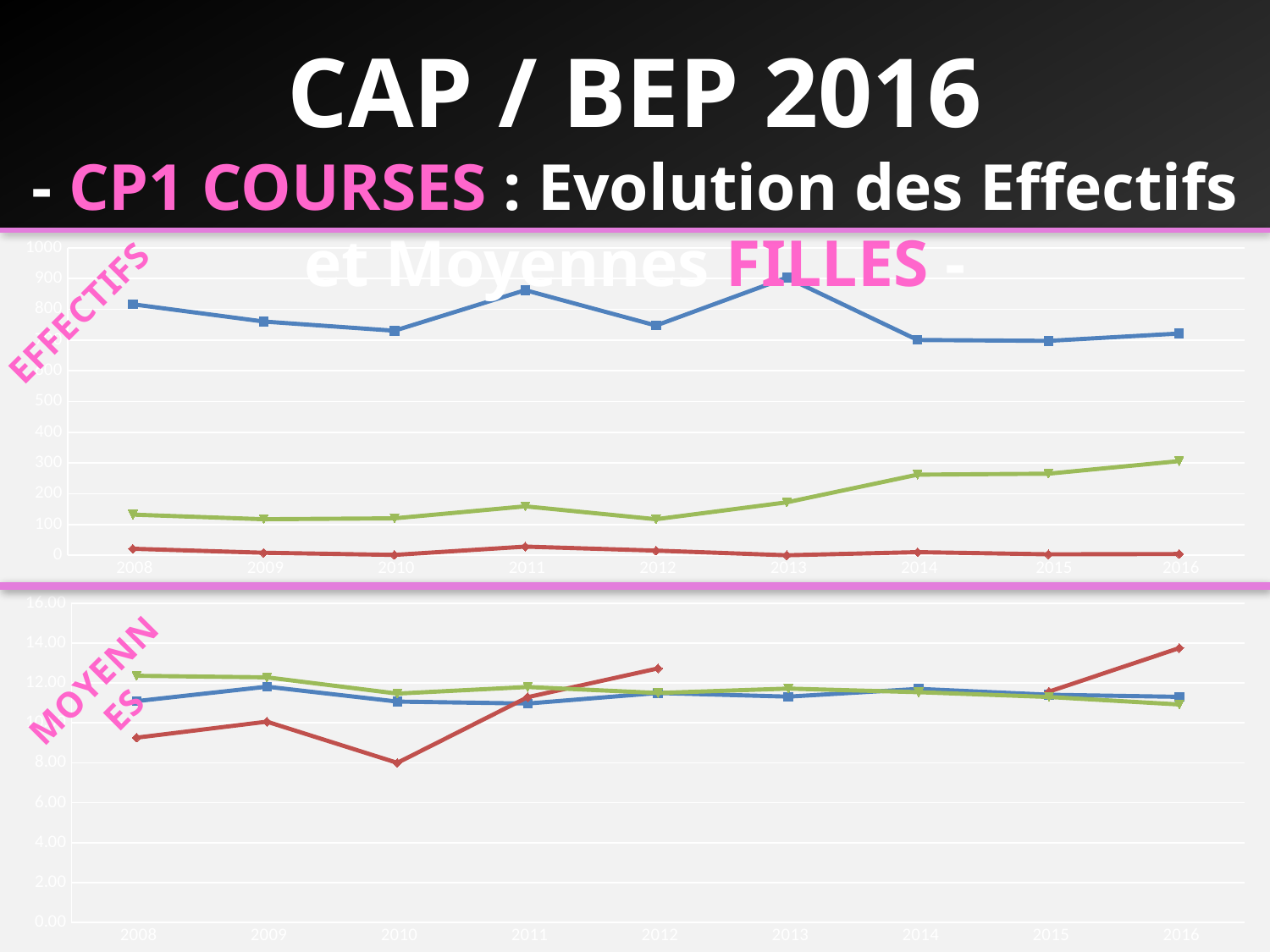
In the top chart (EFFECTIFS), does the green line generally rise or fall from 2012 to 2016? Rise In the top chart (EFFECTIFS), is the value of the green line for 2016 greater or less than 200? greater In the bottom chart (MOYENNES), in which year does the red line reach its lowest value? 2010 What type of chart is the bottom chart (MOYENNES)? Line chart In the top chart (EFFECTIFS), how many lines are plotted? 3 In the top chart (EFFECTIFS), in which year does the green line reach its highest value? 2016 What type of chart is the top chart (EFFECTIFS)? Line chart In the bottom chart (MOYENNES), is the value of the red line for 2010 greater or less than 10.00? less In the top chart (EFFECTIFS), for 2016, which line has the larger value, the blue line or the green line? Blue line In the top chart (EFFECTIFS), is the value of the blue line for 2013 greater or less than 800? greater In the top chart (EFFECTIFS), how many years are shown on the x axis? 9